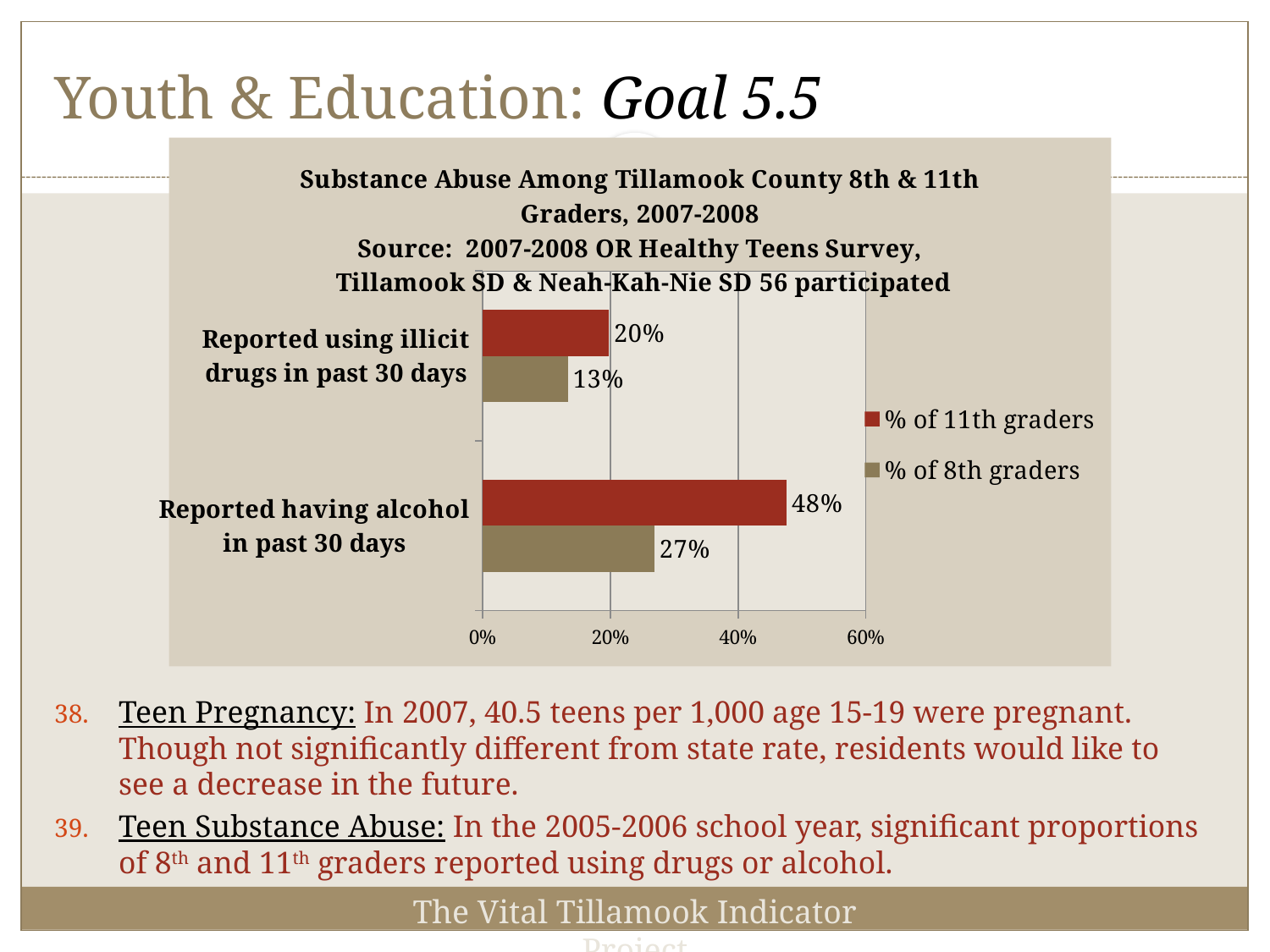
Which category has the highest value for 11th graders? Reported having alcohol in past 30 days Which is larger: the percentage of 11th graders or 8th graders who reported using illicit drugs in the past 30 days? % of 11th graders How many categories are shown on the chart? 2 Which category has the lowest value for 8th graders? Reported using illicit drugs in past 30 days What percentage of 11th graders reported using illicit drugs in the past 30 days? 20% What percentage of 11th graders reported having alcohol in the past 30 days? 48% What kind of chart is shown on the slide? Bar chart What is the difference between the percentage of 11th graders and 8th graders who reported having alcohol in the past 30 days? 21% What is the source of the data cited in the chart title? 2007-2008 OR Healthy Teens Survey How many series does the legend list? 2 What percentage of 8th graders reported using illicit drugs in the past 30 days? 13% What percentage of 8th graders reported having alcohol in the past 30 days? 27%